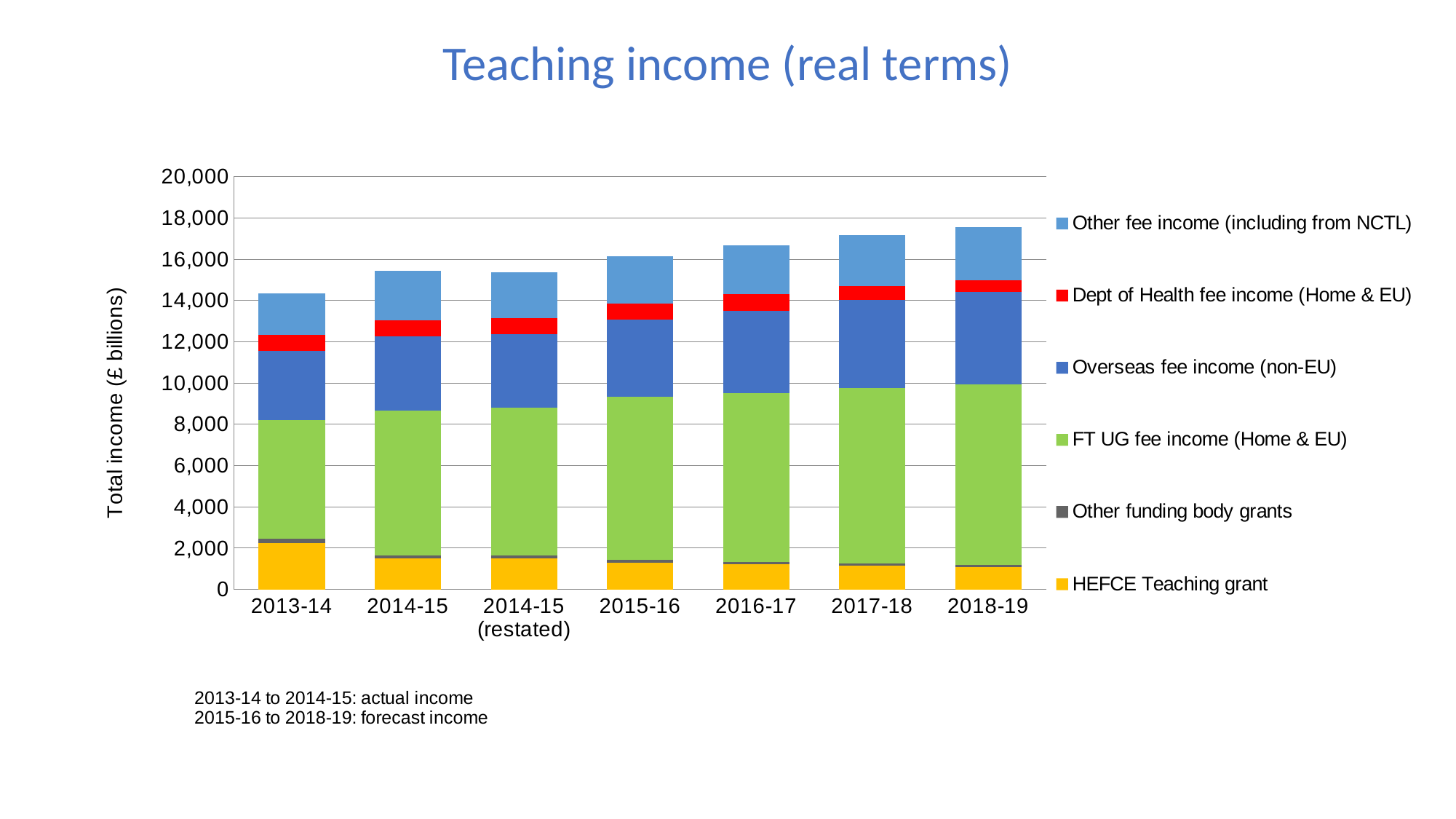
How many year categories are shown along the x axis? 7 Is the total teaching income for 2018-19 greater or less than 16,000? greater What kind of chart is shown on the slide? Stacked bar chart How many series does the legend list? 6 Does the total teaching income generally rise or fall from 2013-14 to 2018-19? rise Which year has the lowest total teaching income? 2013-14 Is the total teaching income for 2013-14 greater or less than 16,000? less What is the label on the vertical axis of the chart? Total income (£ billions) Is the HEFCE Teaching grant for 2018-19 greater or less than 2,000? less Which year has the highest total teaching income? 2018-19 Which is larger, the total teaching income for 2018-19 or for 2013-14? 2018-19